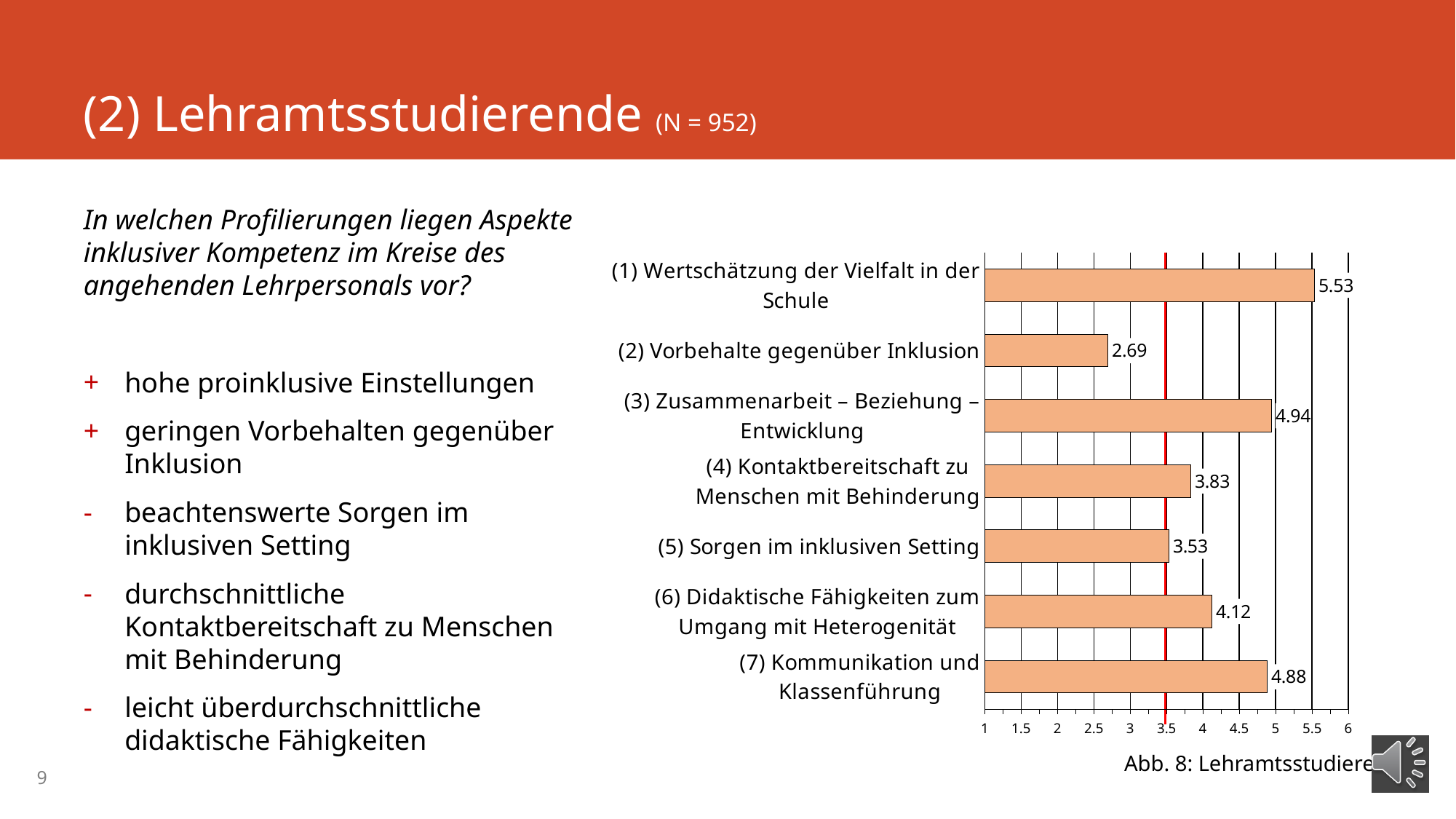
Which category has the lowest value? (2) Vorbehalte gegenüber Inklusion What is the value for (7) Kommunikation und Klassenführung? 4.88 What is the value for (5) Sorgen im inklusiven Setting? 3.53 How many categories are shown in the chart? 7 What is the value for (1) Wertschätzung der Vielfalt in der Schule? 5.53 What is the value for (6) Didaktische Fähigkeiten zum Umgang mit Heterogenität? 4.12 Which is larger, the value for (6) Didaktische Fähigkeiten zum Umgang mit Heterogenität or the value for (7) Kommunikation und Klassenführung? (7) Kommunikation und Klassenführung What is the difference between the values for (3) Zusammenarbeit – Beziehung – Entwicklung and (4) Kontaktbereitschaft zu Menschen mit Behinderung? 1.11 Which category has the highest value? (1) Wertschätzung der Vielfalt in der Schule What kind of chart is shown on the slide? bar chart At what value on the x axis is the red vertical line drawn? 3.5 Is the value for (2) Vorbehalte gegenüber Inklusion greater or less than 3? less